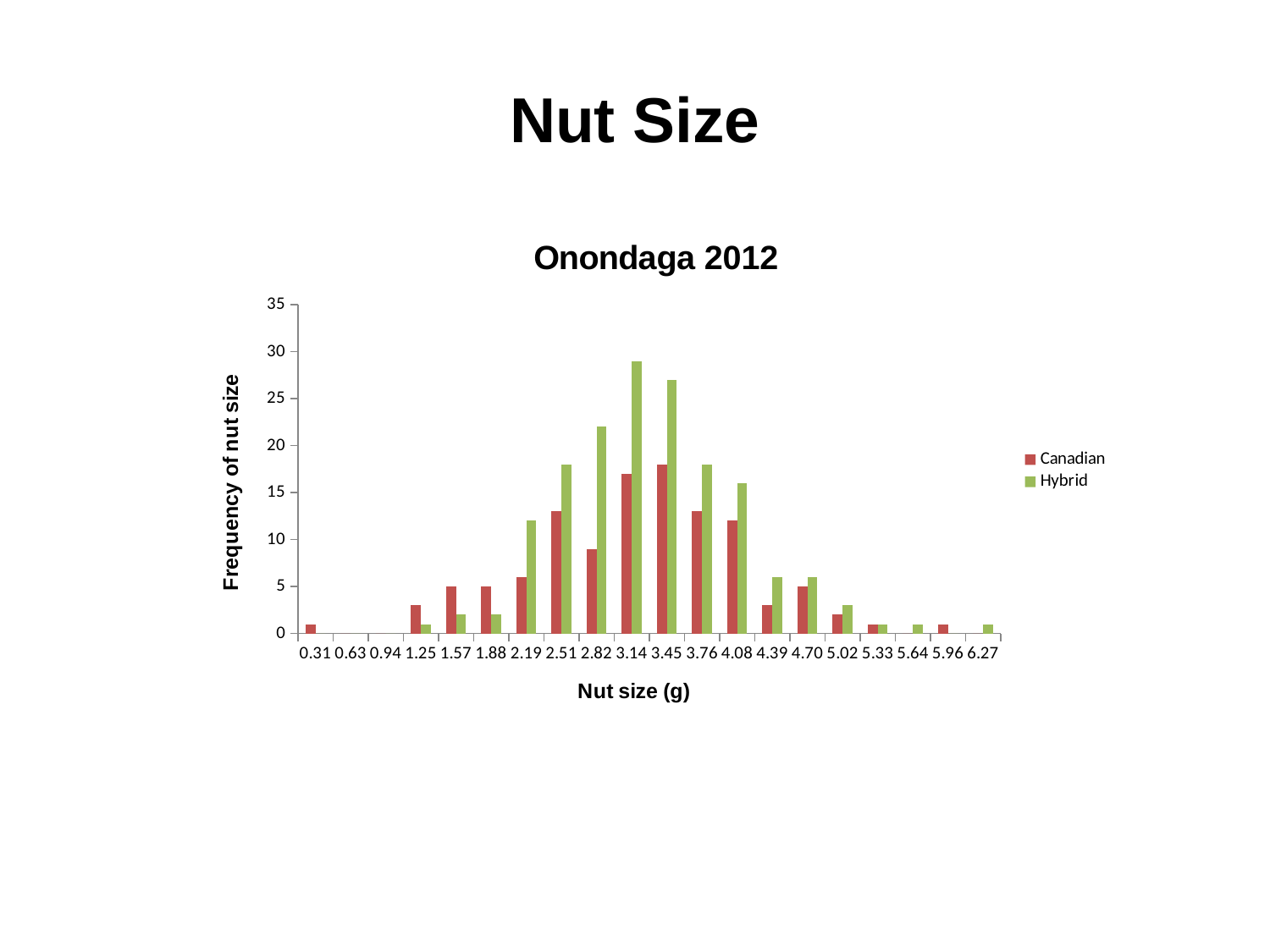
At nut size 1.57, which series has the larger value, Canadian or Hybrid? Canadian What is the title of the chart? Onondaga 2012 For the Hybrid series, which is larger: the value at 3.45 or the value at 3.76? 3.45 Is the Hybrid value at 3.14 greater or less than 25? greater What kind of chart is shown on the slide? bar chart Is the Canadian value at 2.82 greater or less than 10? less How many nut size categories are shown on the x axis? 20 How many series does the legend list? 2 Is the Canadian value at 4.08 greater or less than 10? greater At nut size 2.82, which series has the larger value, Canadian or Hybrid? Hybrid At which nut size does the Hybrid series reach its highest frequency? 3.14